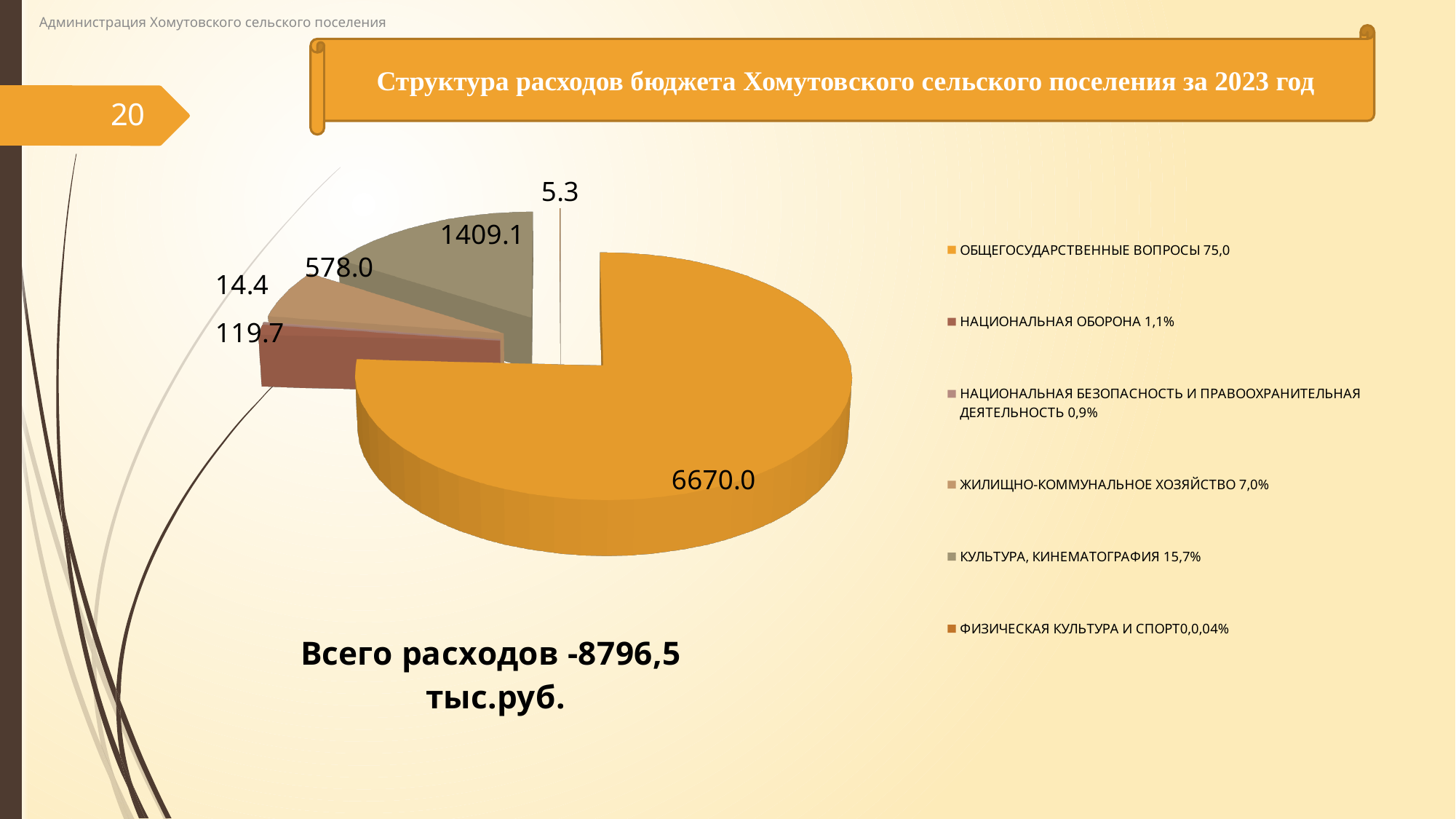
Which category has the largest slice of the pie? ОБЩЕГОСУДАРСТВЕННЫЕ ВОПРОСЫ What is the value shown for ОБЩЕГОСУДАРСТВЕННЫЕ ВОПРОСЫ? 6670.0 Which category has the smallest value in the pie chart? ФИЗИЧЕСКАЯ КУЛЬТУРА И СПОРТ According to the legend, what share of expenditures is КУЛЬТУРА, КИНЕМАТОГРАФИЯ? 15,7% How many categories does the pie chart have? 6 What is the title of the chart? Всего расходов -8796,5 тыс.руб. What is the value shown for КУЛЬТУРА, КИНЕМАТОГРАФИЯ? 1409.1 What is the difference between the values for КУЛЬТУРА, КИНЕМАТОГРАФИЯ and ЖИЛИЩНО-КОММУНАЛЬНОЕ ХОЗЯЙСТВО? 831.1 Which is larger, the value for НАЦИОНАЛЬНАЯ ОБОРОНА or the value for ЖИЛИЩНО-КОММУНАЛЬНОЕ ХОЗЯЙСТВО? ЖИЛИЩНО-КОММУНАЛЬНОЕ ХОЗЯЙСТВО What is the value shown for ЖИЛИЩНО-КОММУНАЛЬНОЕ ХОЗЯЙСТВО? 578.0 What kind of chart is shown on the slide? pie chart What is the value shown for НАЦИОНАЛЬНАЯ ОБОРОНА? 119.7